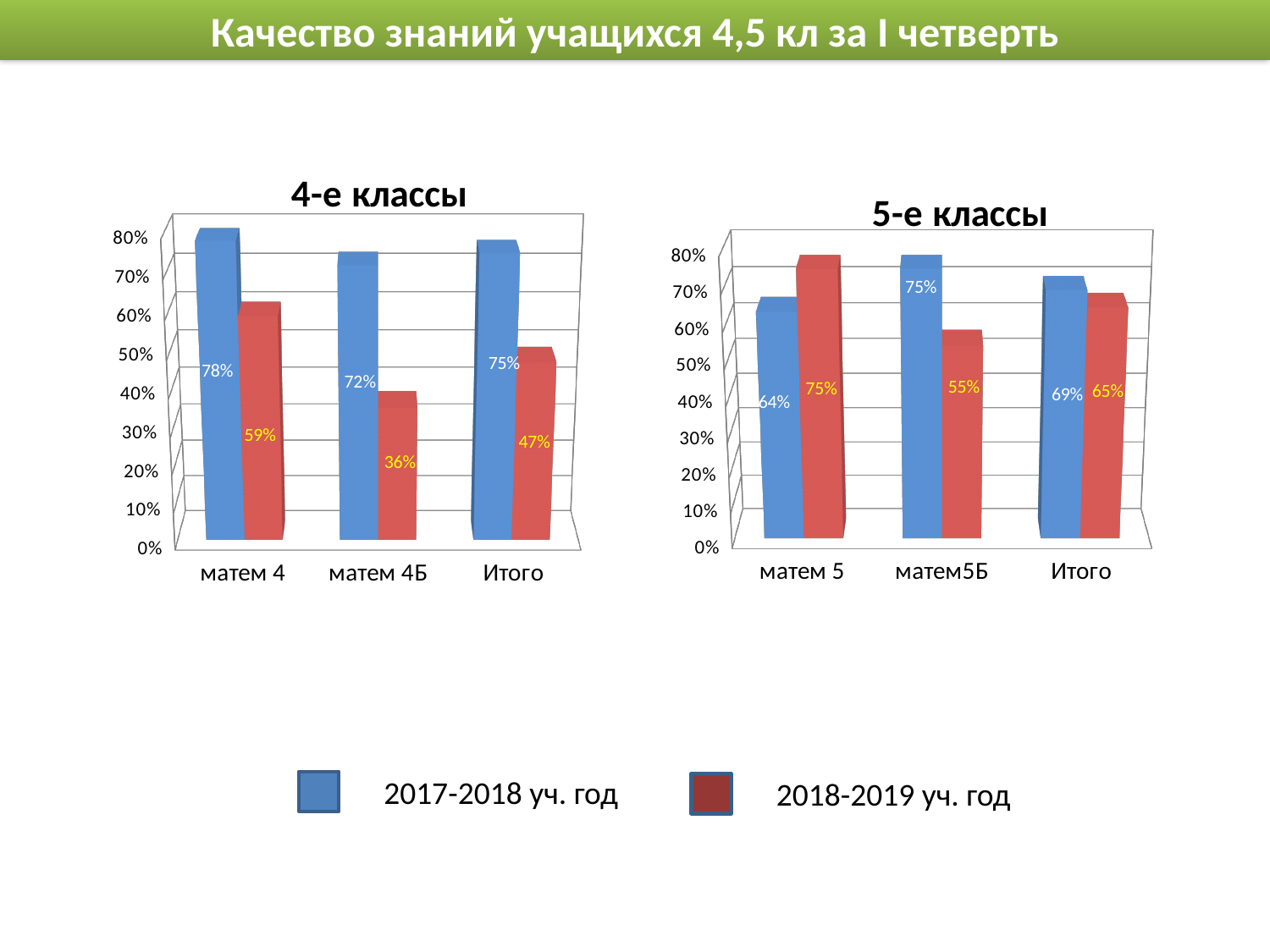
In the '4-е классы' chart, what is the value for матем 4 in 2017-2018 уч. год? 78% In the '5-е классы' chart, which is larger for матем5Б: the 2017-2018 value or the 2018-2019 value? 2017-2018 уч. год In the '5-е классы' chart, what is the difference between the 2018-2019 and 2017-2018 values for матем 5? 11% How many categories are shown on the x axis of the '4-е классы' chart? 3 In the '4-е классы' chart, what is the value for матем 4Б in 2018-2019 уч. год? 36% In the '5-е классы' chart, which category has the highest value for 2017-2018 уч. год? матем5Б In the '4-е классы' chart, what is the difference between the 2017-2018 and 2018-2019 values for Итого? 28% What type of chart is the '5-е классы' chart? Bar chart In the '4-е классы' chart, which category has the lowest value for 2018-2019 уч. год? матем 4Б How many series does the legend at the bottom of the slide list? 2 In the '5-е классы' chart, what is the Итого value for 2017-2018 уч. год? 69% In the '5-е классы' chart, what is the value for матем 5 in 2018-2019 уч. год? 75%